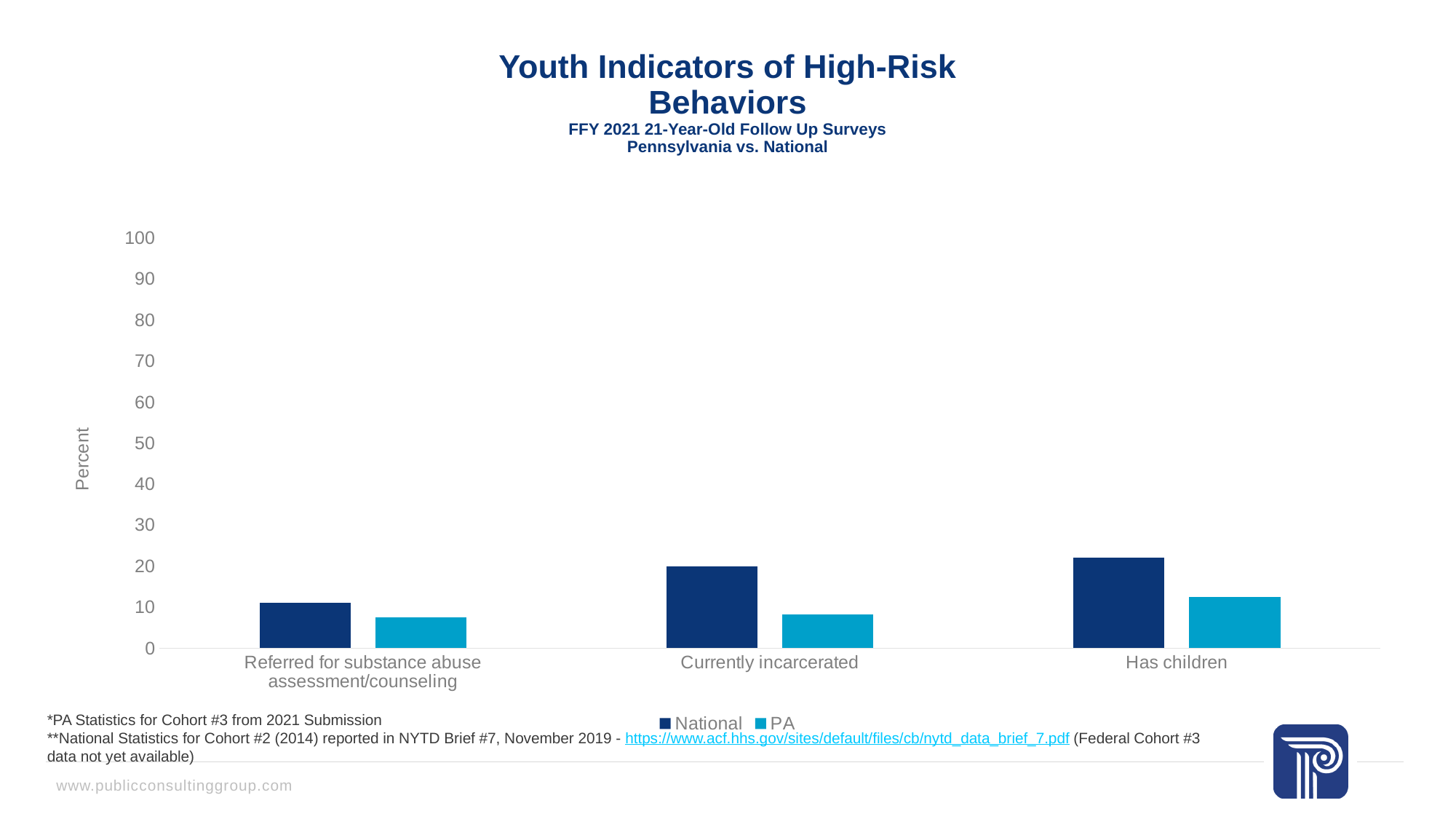
Which category has the highest PA value? Has children How many series does the chart's legend list? 2 Which series has the larger value for Currently incarcerated, National or PA? National What are the two series named in the chart's legend? National and PA Which series has the larger value for Has children, National or PA? National What is the label on the y axis of the chart? Percent Is the National value for Has children greater or less than 30? less What kind of chart is shown on the slide? bar chart How many categories are shown on the x axis of the chart? 3 Is the PA value for Currently incarcerated greater or less than 10? less Is the PA value for Has children greater or less than 10? greater Which series has the larger value for Referred for substance abuse assessment/counseling, National or PA? National